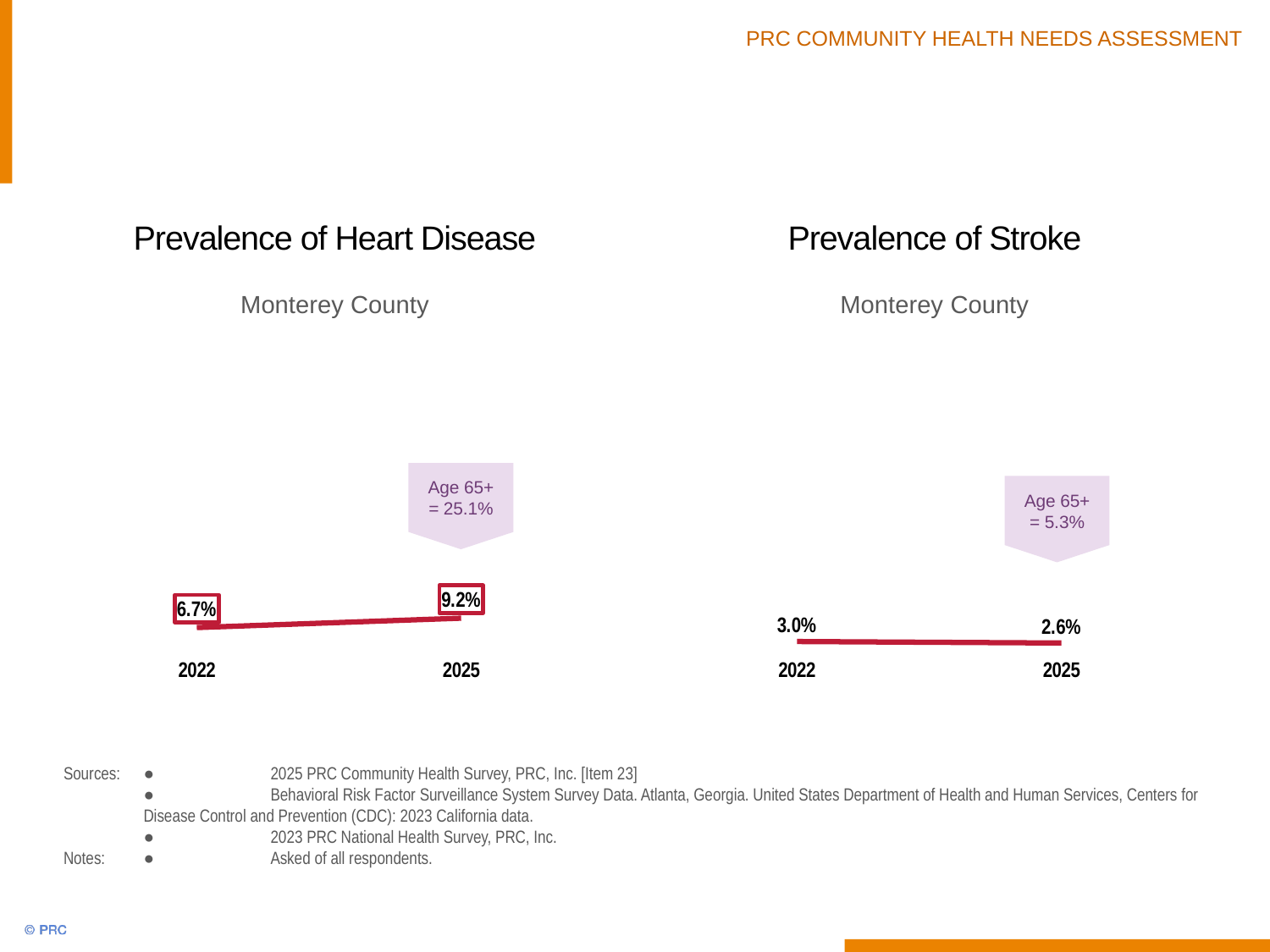
In the Prevalence of Heart Disease chart, how many years are plotted? 2 In the Prevalence of Stroke chart, does the value rise or fall from 2022 to 2025? fall In the Prevalence of Heart Disease chart, what is the value for 2022? 6.7% In the Prevalence of Heart Disease chart, what is the difference between the 2025 and 2022 values? 2.5% In the Prevalence of Stroke chart, what is the value for 2022? 3.0% In the Prevalence of Stroke chart, what is the value for 2025? 2.6% What type of chart is the Prevalence of Stroke chart? line chart In the Prevalence of Heart Disease chart, what is the value for 2025? 9.2% In the Prevalence of Heart Disease chart, does the value rise or fall from 2022 to 2025? rise In the Prevalence of Stroke chart, what is the difference between the 2022 and 2025 values? 0.4% In the Prevalence of Stroke chart, which year has the higher value, 2022 or 2025? 2022 In the Prevalence of Heart Disease chart, what value is shown in the callout for Age 65+? 25.1%